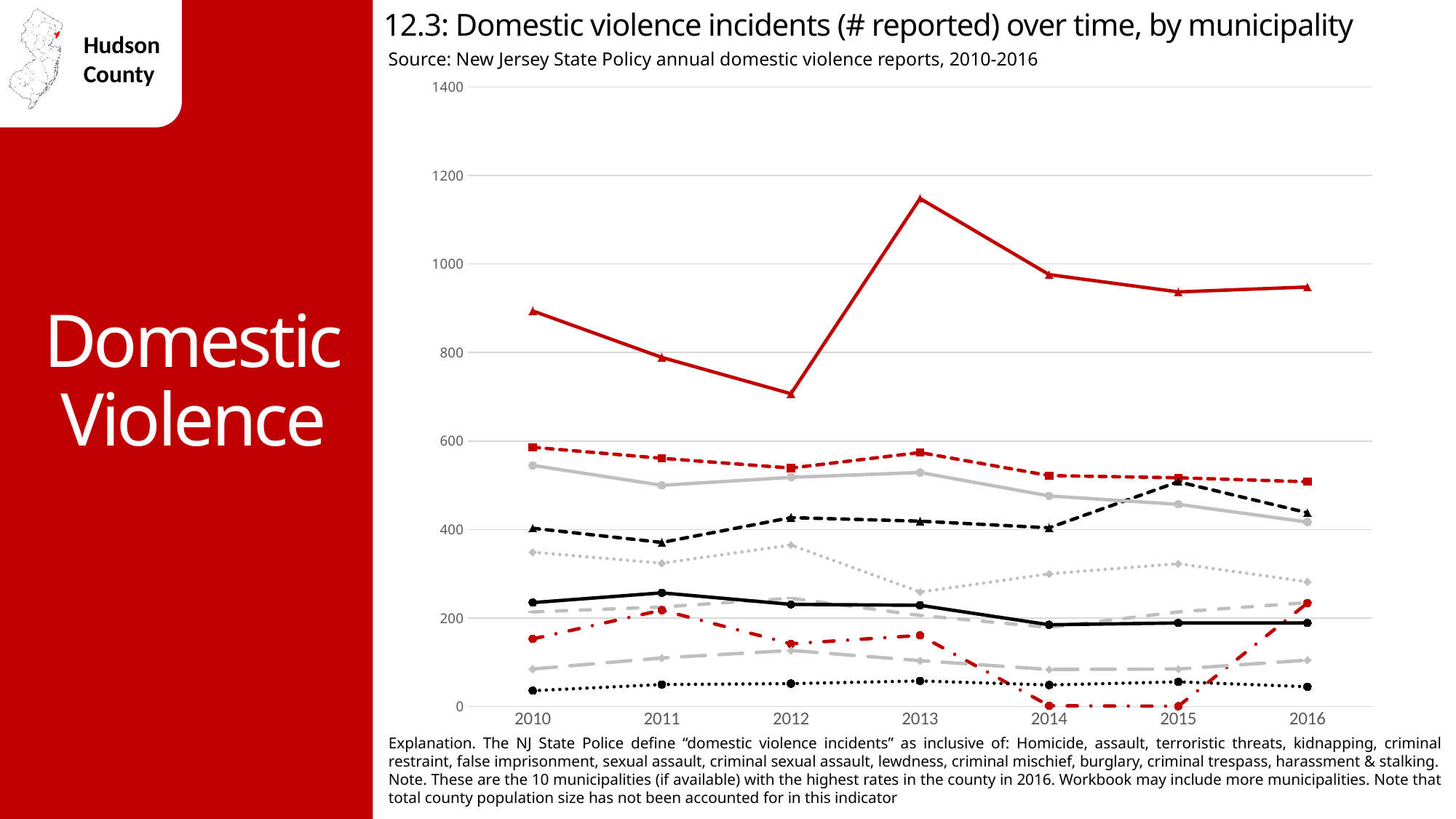
In which year does the top solid red line with triangle markers reach its lowest value? 2012 Is the value of the top solid red line with triangle markers in 2010 greater or less than 800? greater Is the value of the red dashed line with square markers in 2014 greater or less than 400? greater Does the top solid red line with triangle markers rise or fall from 2010 to 2012? fall What is the title of the chart on the slide? 12.3: Domestic violence incidents (# reported) over time, by municipality In which year does the top solid red line with triangle markers reach its highest value? 2013 What kind of chart is shown on the slide? line chart Is the value of the top solid red line with triangle markers in 2012 greater or less than 800? less How many years are plotted along the x axis of the chart? 7 For the top solid red line with triangle markers, is the value higher in 2014 or in 2015? 2014 What source is cited for the chart data? New Jersey State Policy annual domestic violence reports, 2010-2016